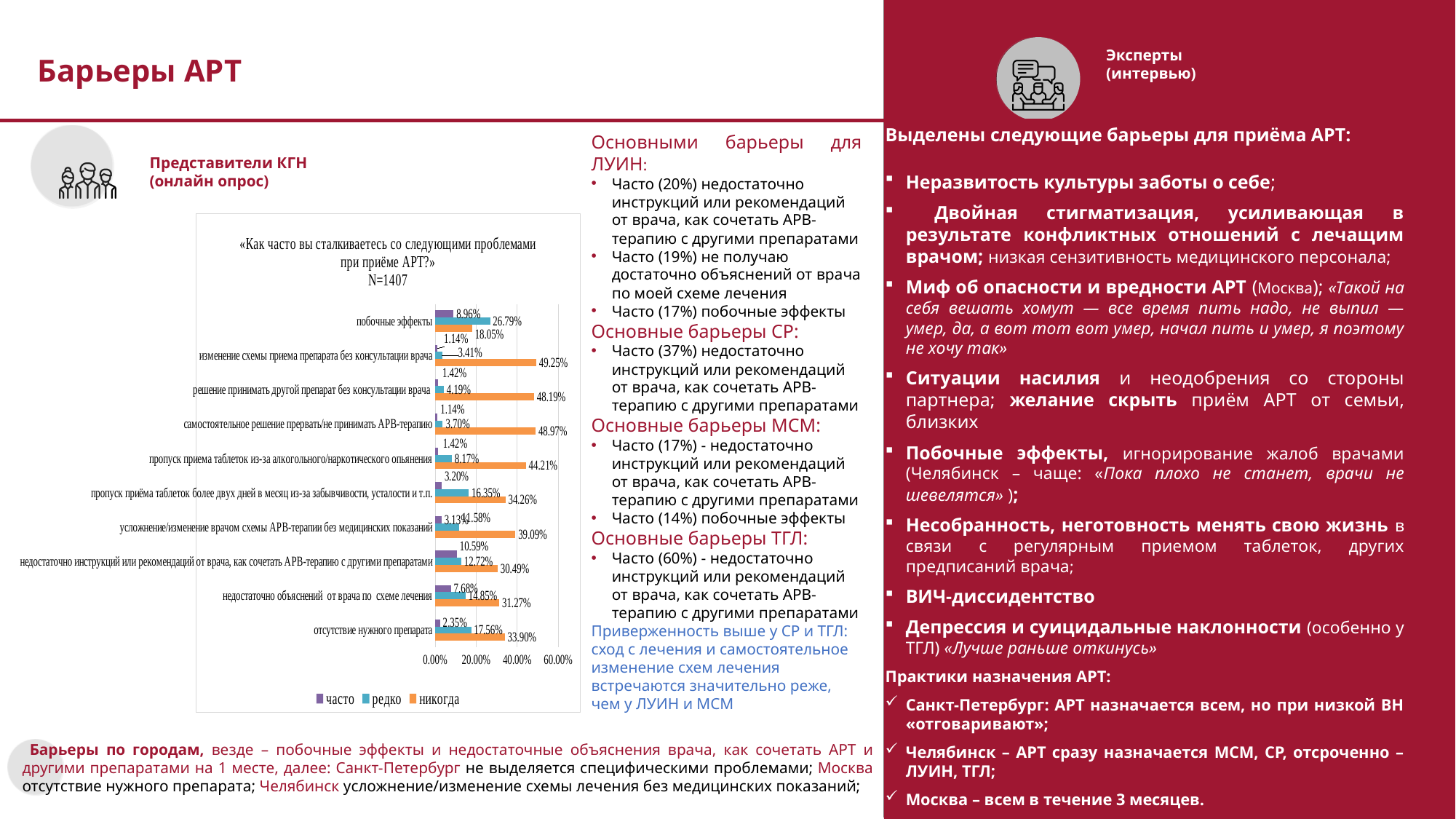
How many categories (problems) are plotted in the chart? 10 What sample size (N) is stated in the chart title? N=1407 Is the «никогда» value for «самостоятельное решение прервать/не принимать АРВ-терапию» greater or less than 40.00%? greater What is the value of «часто» for «побочные эффекты»? 8.96% What is the value of «никогда» for «отсутствие нужного препарата»? 33.90% What is the value of «редко» for «недостаточно объяснений от врача по схеме лечения»? 14.85% What kind of chart is shown on the slide? bar chart How many series does the chart legend list? 3 What is the difference between the «редко» and «часто» values for «побочные эффекты»? 17.83% Which category has the highest «никогда» value? изменение схемы приема препарата без консультации врача Which is larger for «пропуск приема таблеток из-за алкогольного/наркотического опьянения»: «редко» or «часто»? редко Which category has the highest «часто» value? недостаточно инструкций или рекомендаций от врача, как сочетать АРВ-терапию с другими препаратами